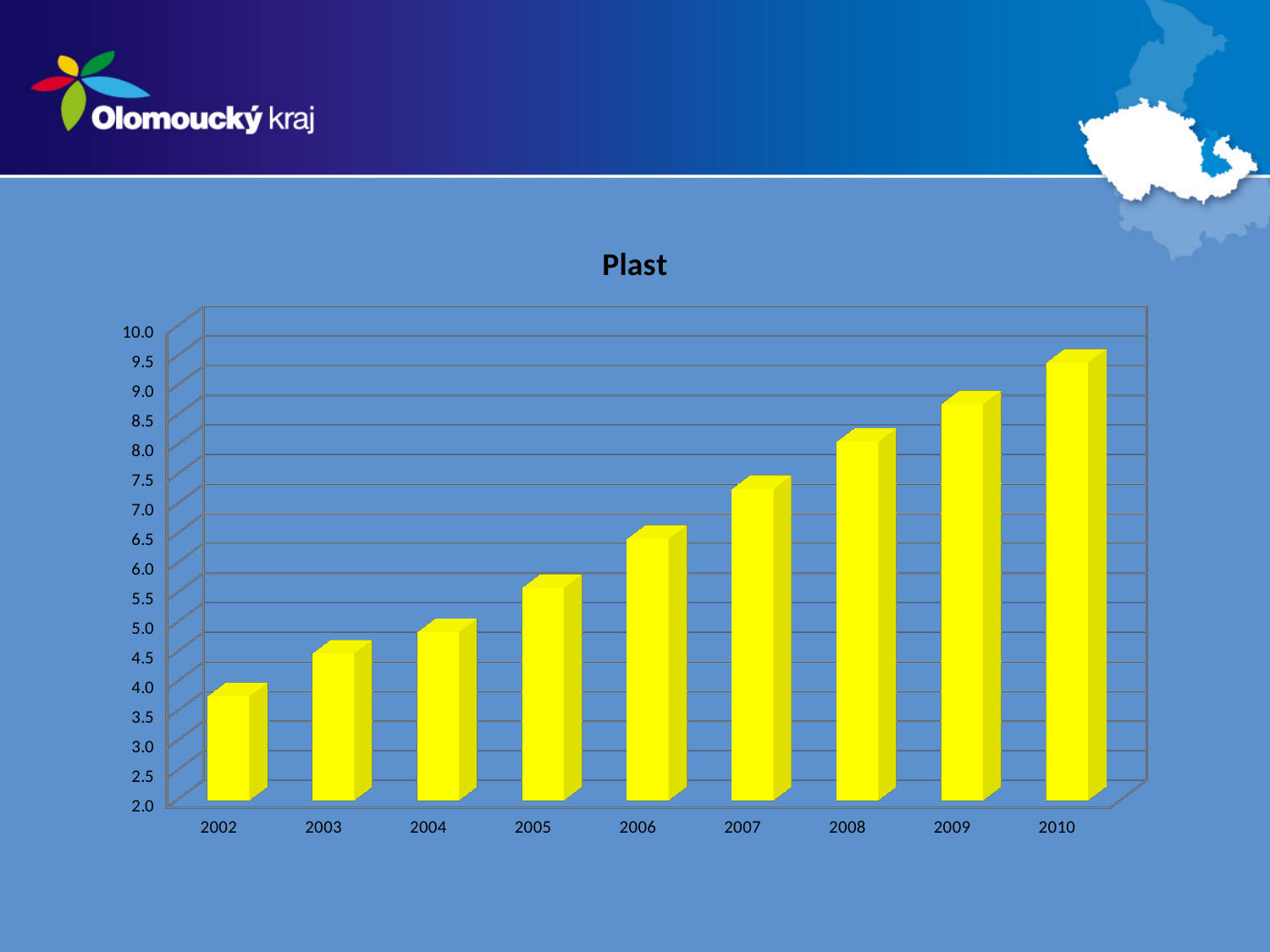
How many years are shown on the x axis of the chart? 9 Which is larger, the value for 2004 or the value for 2007? 2007 What is the title of the chart? Plast What colour are the bars in the chart? yellow Is the value for 2009 greater or less than 9.0? less Is the value for 2002 greater or less than 4.0? less Which year has the highest value in the chart? 2010 Which year has the lowest value in the chart? 2002 What kind of chart is shown on the slide? bar chart Do the values rise or fall from 2002 to 2010? rise